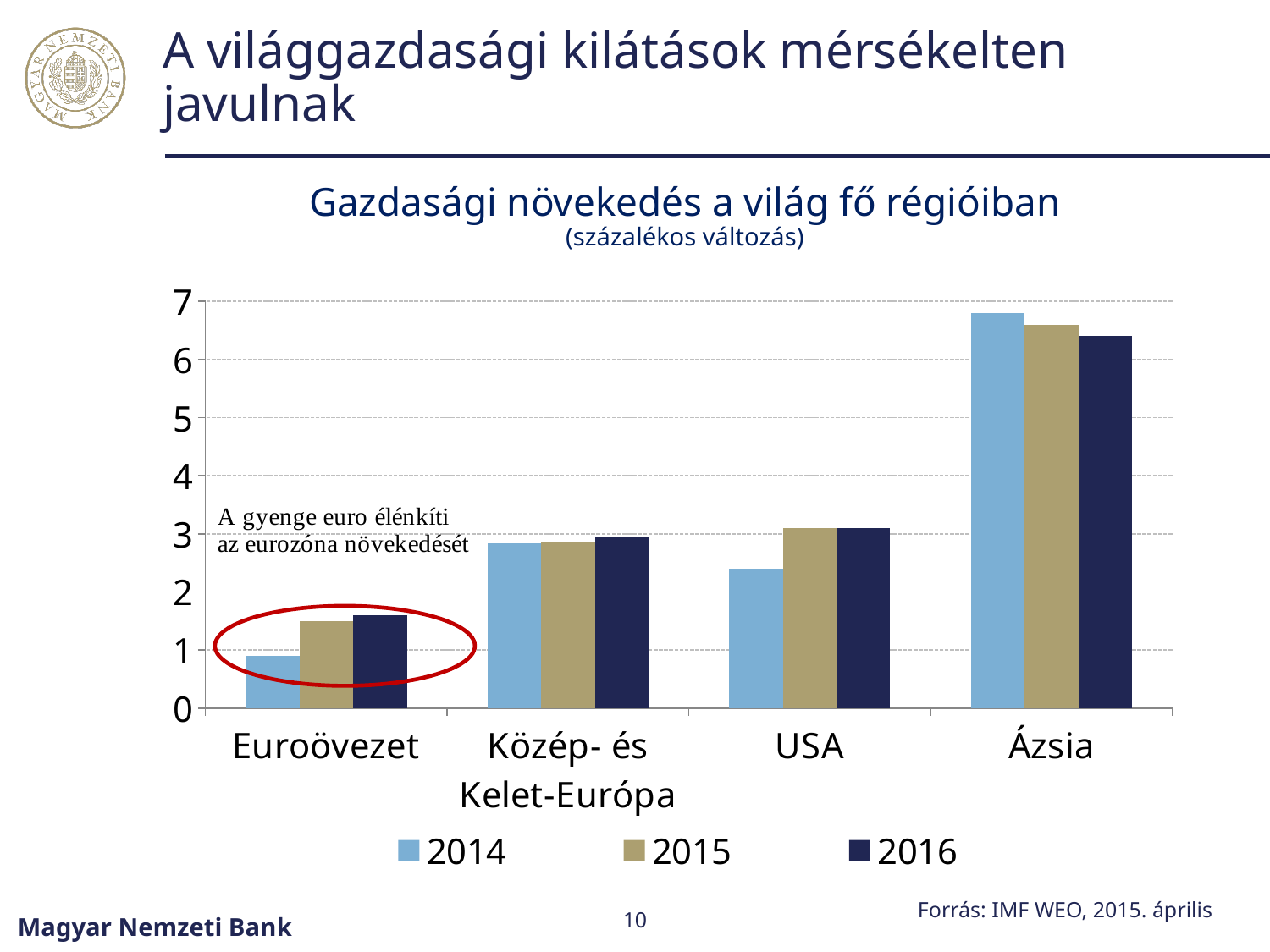
Do the values for Ázsia rise or fall from 2014 to 2016? fall Do the values for Euroövezet rise or fall from 2014 to 2016? rise How many regions are shown on the x axis of the chart? 4 Is the 2016 value for Ázsia greater or less than 6? greater Is the 2014 value for Euroövezet greater or less than 1? less Which is larger for 2014: the value for USA or the value for Közép- és Kelet-Európa? Közép- és Kelet-Európa What is the title of the chart? Gazdasági növekedés a világ fő régióiban Which region has the highest value for 2014? Ázsia What kind of chart is shown on the slide? bar chart Which region has the lowest value for 2014? Euroövezet How many series does the legend list? 3 Is the 2014 value for USA greater or less than 3? less